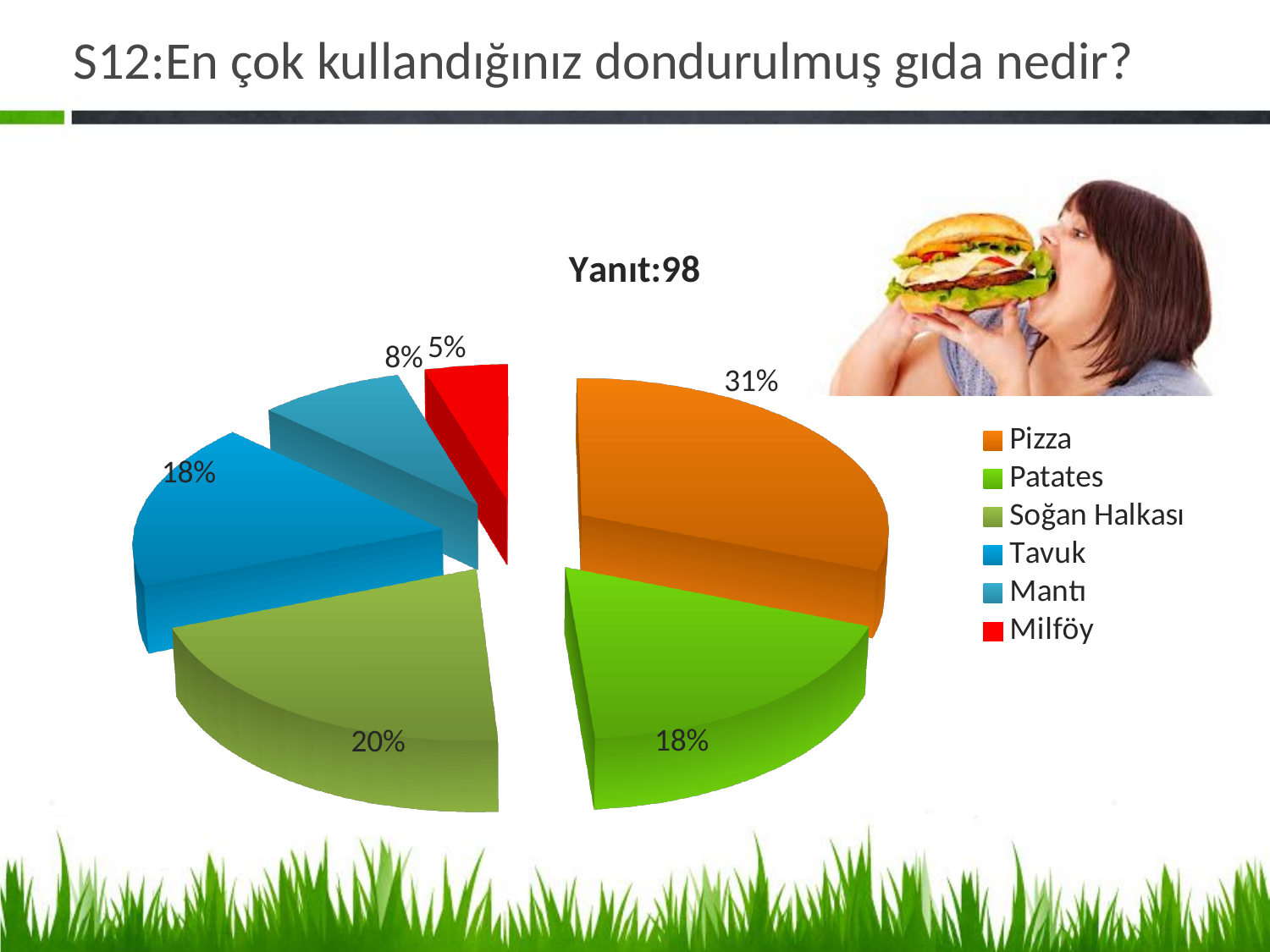
What is the difference in percentage points between Mantı and Milföy? 3 What is the title shown above the pie chart? Yanıt:98 What share of the pie does Soğan Halkası have? 20% What kind of chart is shown on the slide? Pie chart Which is larger, the share for Soğan Halkası or the share for Patates? Soğan Halkası Which category has the largest slice of the pie? Pizza What share of the pie does Milföy have? 5% What share of the pie does Pizza have? 31% Which category has the smallest slice of the pie? Milföy How many categories does the pie chart show? 6 What is the difference in percentage points between Pizza and Soğan Halkası? 11 What share of the pie does Mantı have? 8%